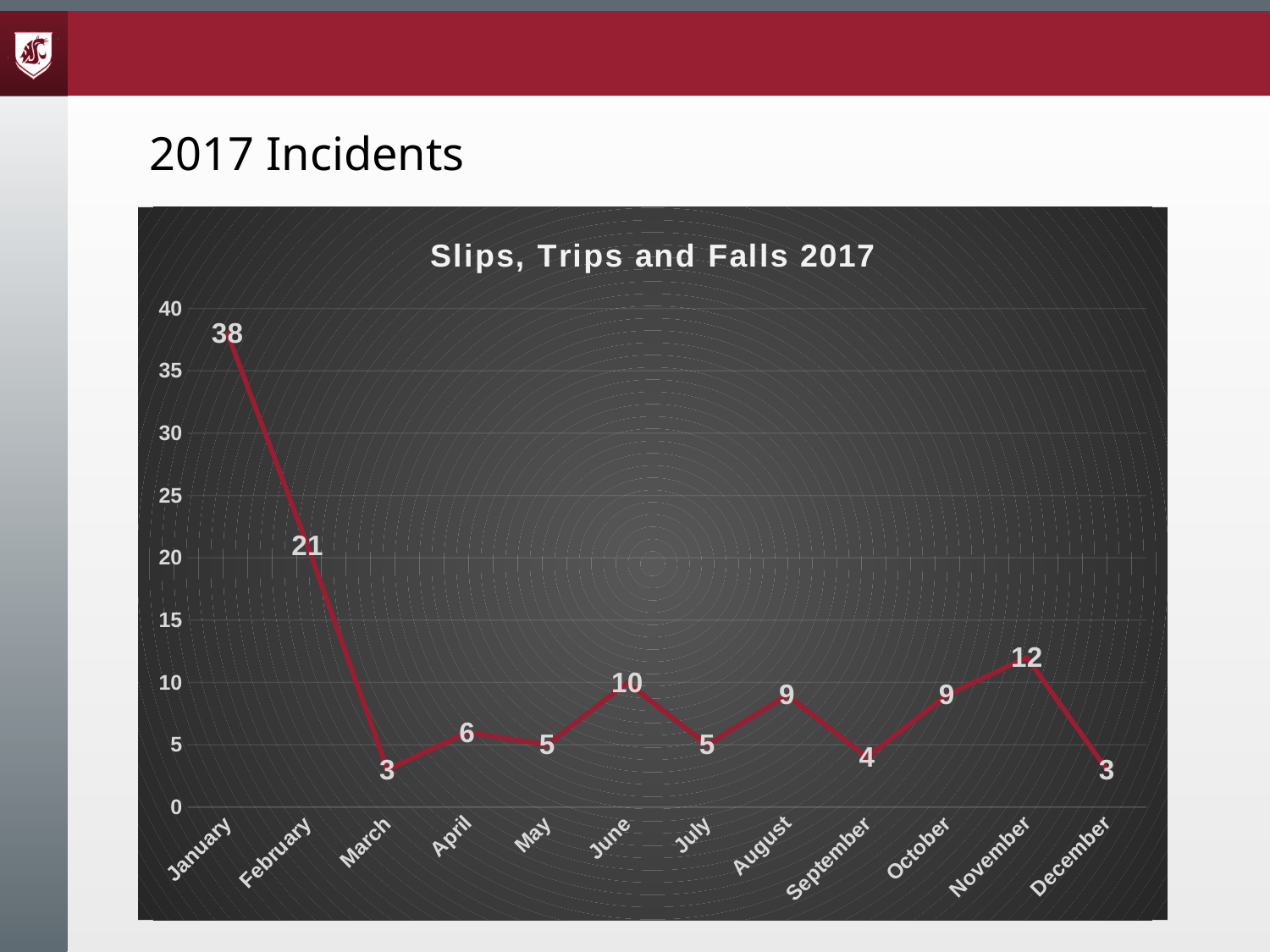
What kind of chart is shown? Line chart What is the difference between the values for January and February? 17 What is the value for September? 4 What is the value for November? 12 Do the values rise or fall from January to March? Fall What is the difference between the values for November and December? 9 Is the value for February greater or less than 20? greater Which month has the highest value? January What is the value for January? 38 How many months are plotted on the chart? 12 Which is larger, the value for June or the value for August? June What is the title of the chart? Slips, Trips and Falls 2017